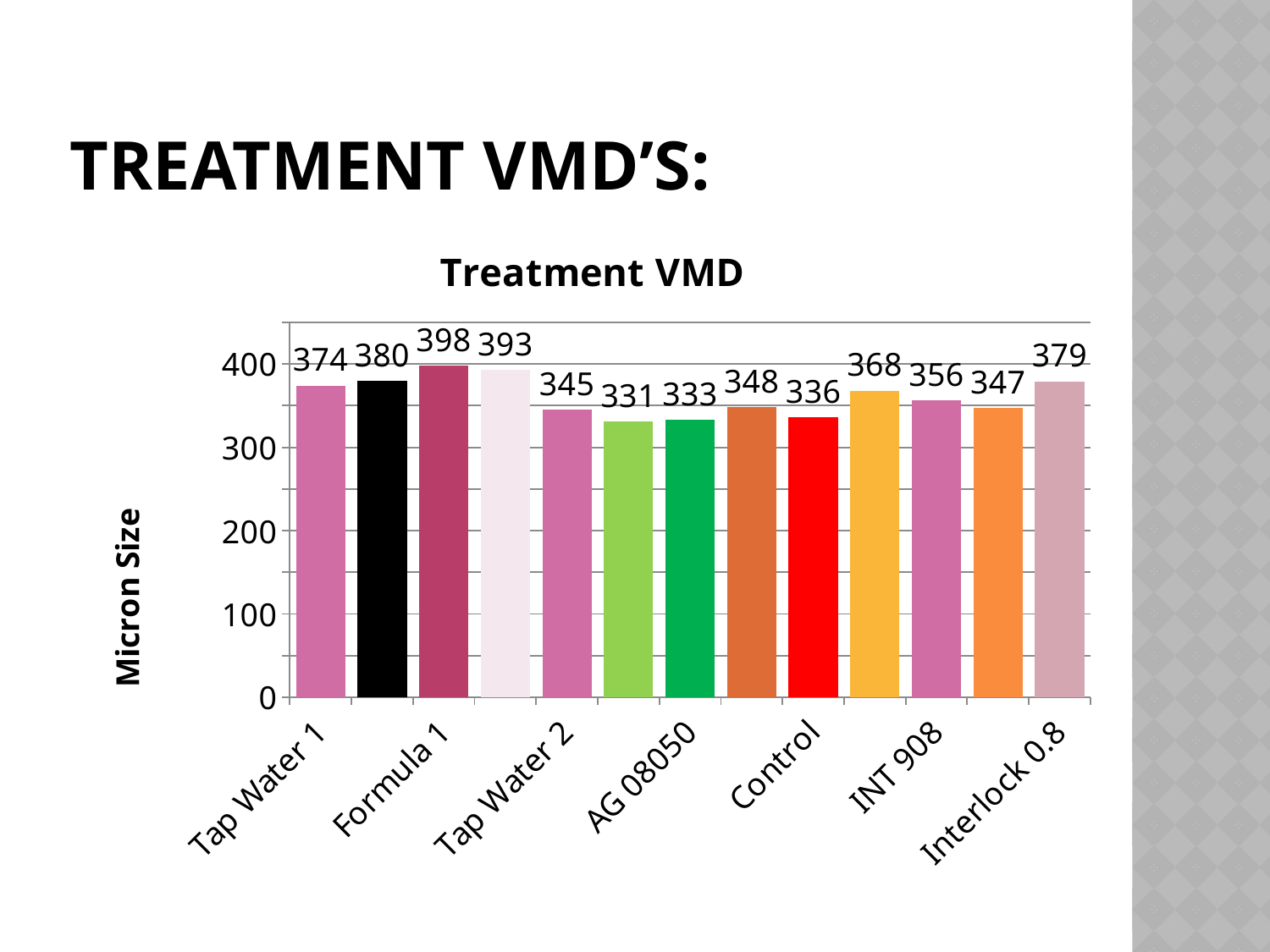
What is the value for Tap Water 1? 374 What kind of chart is shown? Bar chart What is the difference between the values for Formula 1 and Control? 62 What is the value for Formula 1? 398 What is the value for Control? 336 Which is larger, the value for Tap Water 2 or the value for Interlock 0.8? Interlock 0.8 Which labeled category has the highest value? Formula 1 What is the value for INT 908? 356 How many bars are plotted in the chart? 13 What is the lowest value shown on any bar in the chart? 331 What is the label on the vertical axis? Micron Size What is the value for Interlock 0.8? 379